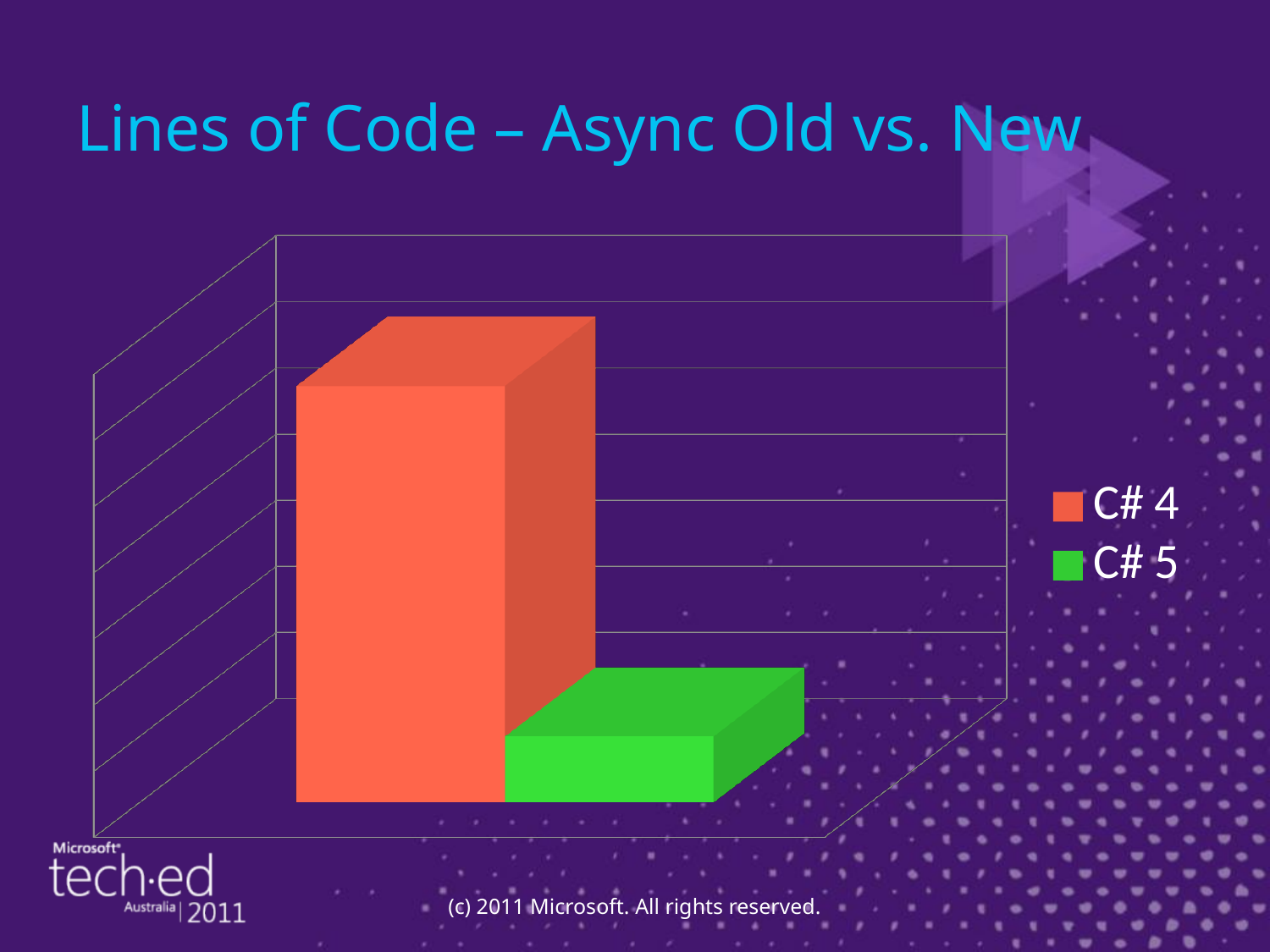
What kind of chart is shown on the slide? bar chart How many series does the legend list? 2 Is the bar for C# 5 taller or shorter than the bar for C# 4? shorter Which series has the highest bar in the chart? C# 4 What colour is the bar for C# 5 in the chart? green How many bars are plotted in the chart? 2 Which series has the taller bar, C# 4 or C# 5? C# 4 Which series has the lowest bar in the chart? C# 5 What is the title of the slide containing the chart? Lines of Code – Async Old vs. New